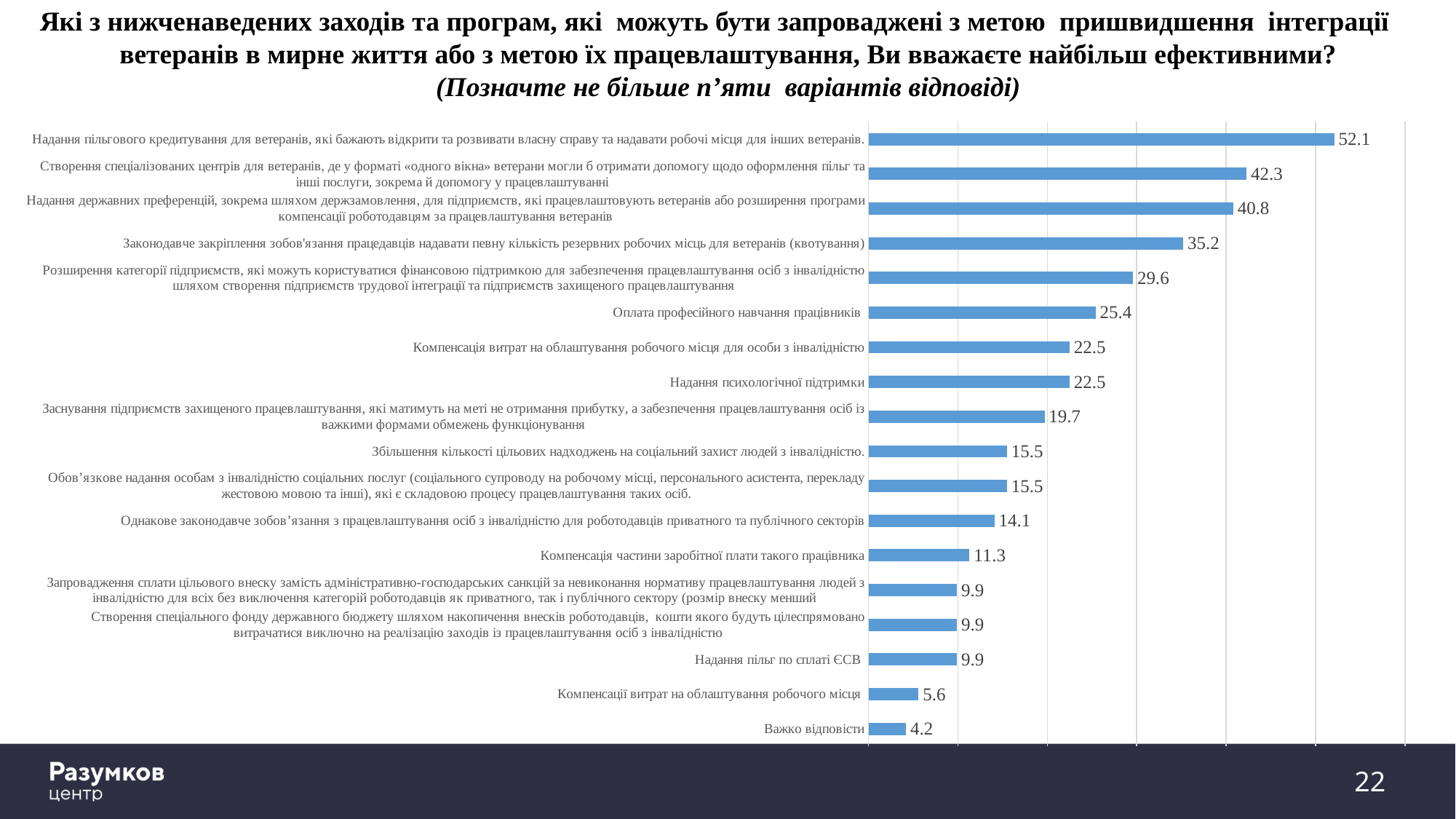
What type of chart is shown on the slide? bar chart What is the difference between the values for "Компенсації витрат на облаштування робочого місця" and "Важко відповісти"? 1.4 What is the value for "Надання пільгового кредитування для ветеранів, які бажають відкрити та розвивати власну справу та надавати робочі місця для інших ветеранів"? 52.1 What is the value for "Оплата професійного навчання працівників"? 25.4 Which category has the lowest value? Важко відповісти Which category has the highest value? Надання пільгового кредитування для ветеранів, які бажають відкрити та розвивати власну справу та надавати робочі місця для інших ветеранів How many categories (bars) are shown in the chart? 18 What is the value for "Надання пільг по сплаті ЄСВ"? 9.9 Which is larger: the value for "Компенсація частини заробітної плати такого працівника" or the value for "Однакове законодавче зобов’язання з працевлаштування осіб з інвалідністю для роботодавців приватного та публічного секторів"? Однакове законодавче зобов’язання з працевлаштування осіб з інвалідністю для роботодавців приватного та публічного секторів What is the value for "Важко відповісти"? 4.2 What is the difference between the values for "Створення спеціалізованих центрів для ветеранів..." (42.3) and "Законодавче закріплення зобов'язання працедавців надавати певну кількість резервних робочих місць для ветеранів (квотування)"? 7.1 What is the value for "Надання психологічної підтримки"? 22.5